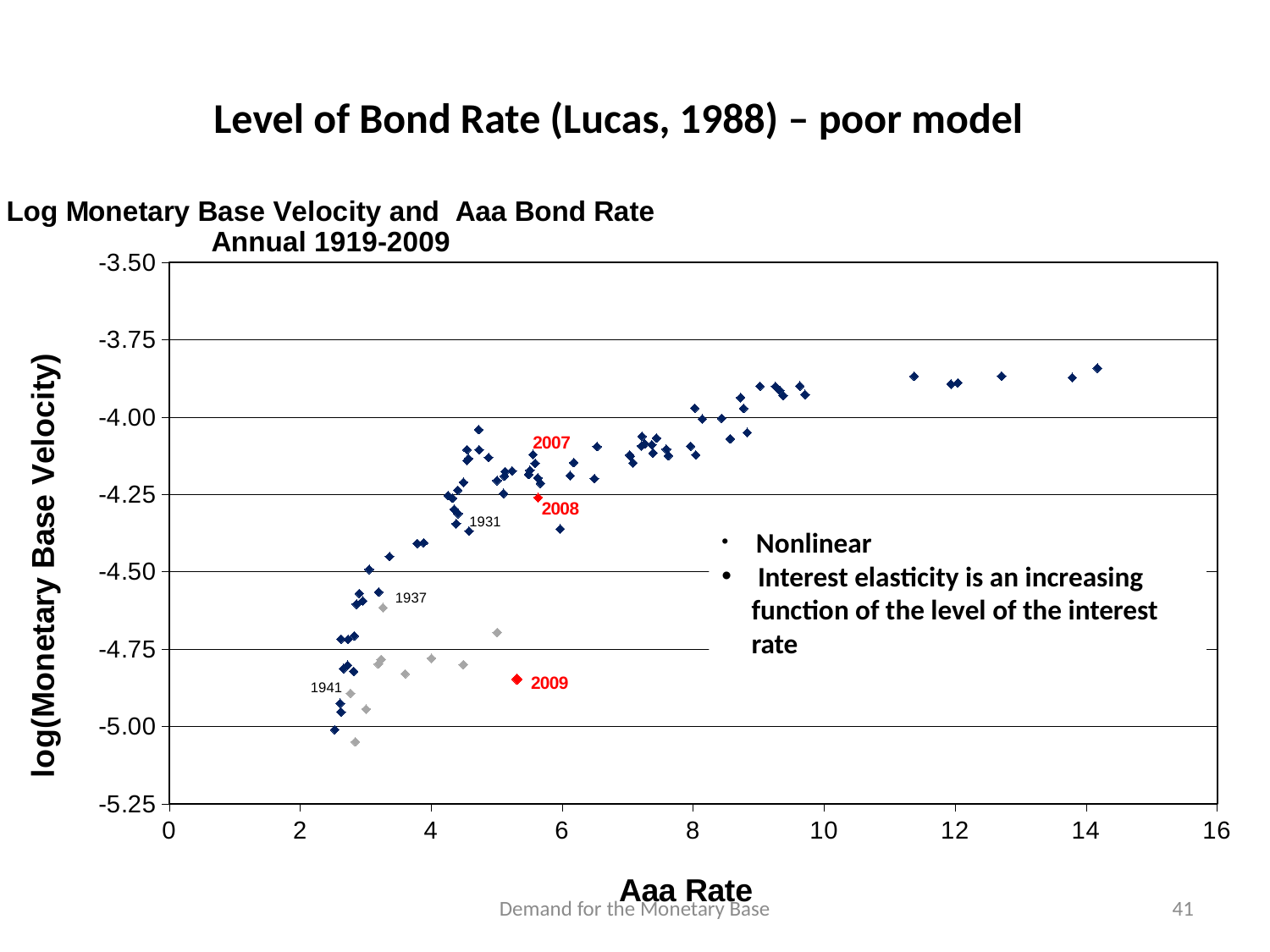
Is the log(Monetary Base Velocity) value for the point labelled 1931 greater or less than -4.50? greater What is the label of the x axis of the chart? Aaa Rate Is the log(Monetary Base Velocity) value for the point labelled 2008 greater or less than -4.00? less Is the Aaa Rate for the point labelled 1941 greater or less than 4? less As the Aaa Rate increases along the x axis, does log(Monetary Base Velocity) generally rise or fall? rise Which point has the higher log(Monetary Base Velocity), the one labelled 1931 or the one labelled 1941? 1931 Which point has the higher log(Monetary Base Velocity), the one labelled 2008 or the one labelled 2009? 2008 What is the title of the chart? Log Monetary Base Velocity and Aaa Bond Rate Annual 1919-2009 What kind of chart is shown on the slide? scatter chart